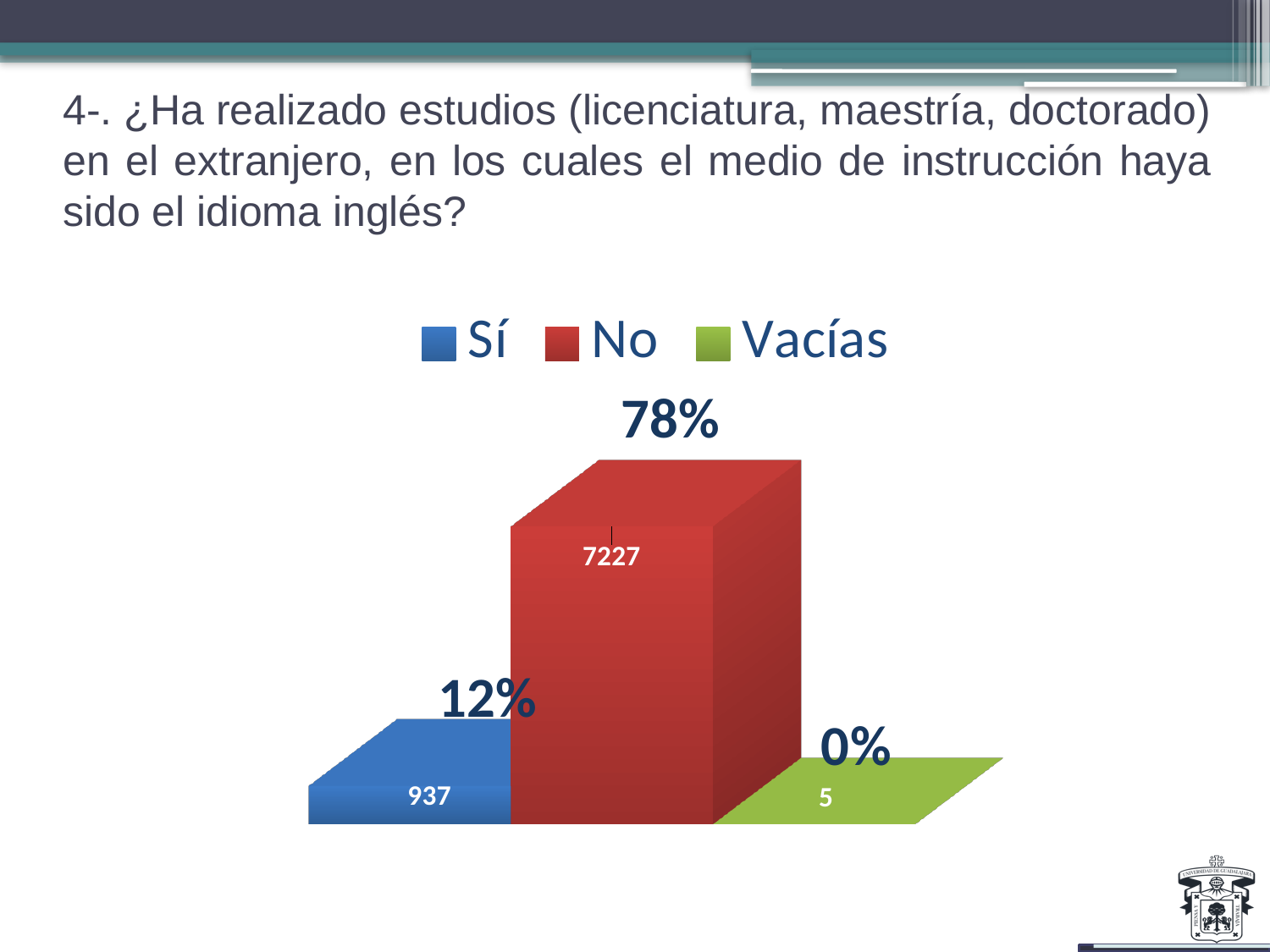
What count is shown for the "No" bar? 7227 What count is shown for the "Vacías" bar? 5 Which category has the lowest value? Vacías How many entries does the legend list? 3 What type of chart is shown on the slide? Bar chart What percentage is shown above the "No" bar? 78% What percentage is shown above the "Vacías" bar? 0% Which category has the highest value? No What percentage is shown above the "Sí" bar? 12% What count is shown for the "Sí" bar? 937 What is the difference between the counts for "No" and "Sí"? 6290 Which is larger, the count for "Sí" or the count for "Vacías"? Sí